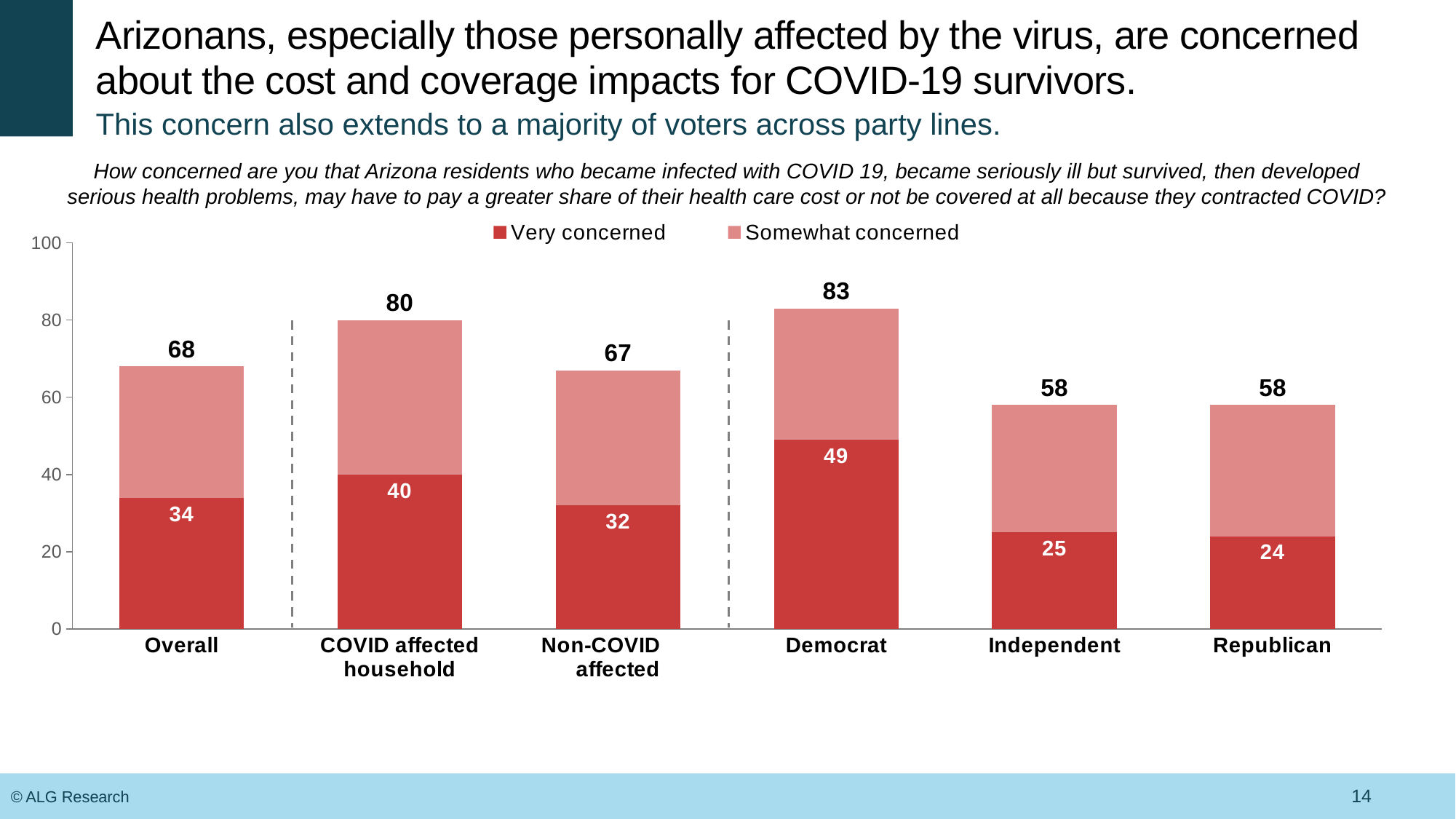
Which is larger, the total for Overall or the total for Non-COVID affected? Overall What is the 'Very concerned' value for Republican? 24 What is the 'Very concerned' value for Democrat? 49 Is the total for Independent greater or less than 60? less Which category has the lowest 'Very concerned' value? Republican Which legend entry is shown in the darker red colour? Very concerned What kind of chart is shown on the slide? Stacked bar chart How many series does the legend list? 2 How many categories are shown on the x axis? 6 What is the total (Very concerned plus Somewhat concerned) shown above the bar for COVID affected household? 80 Which category has the highest total concerned value? Democrat What is the difference between the 'Very concerned' values for COVID affected household and Non-COVID affected? 8